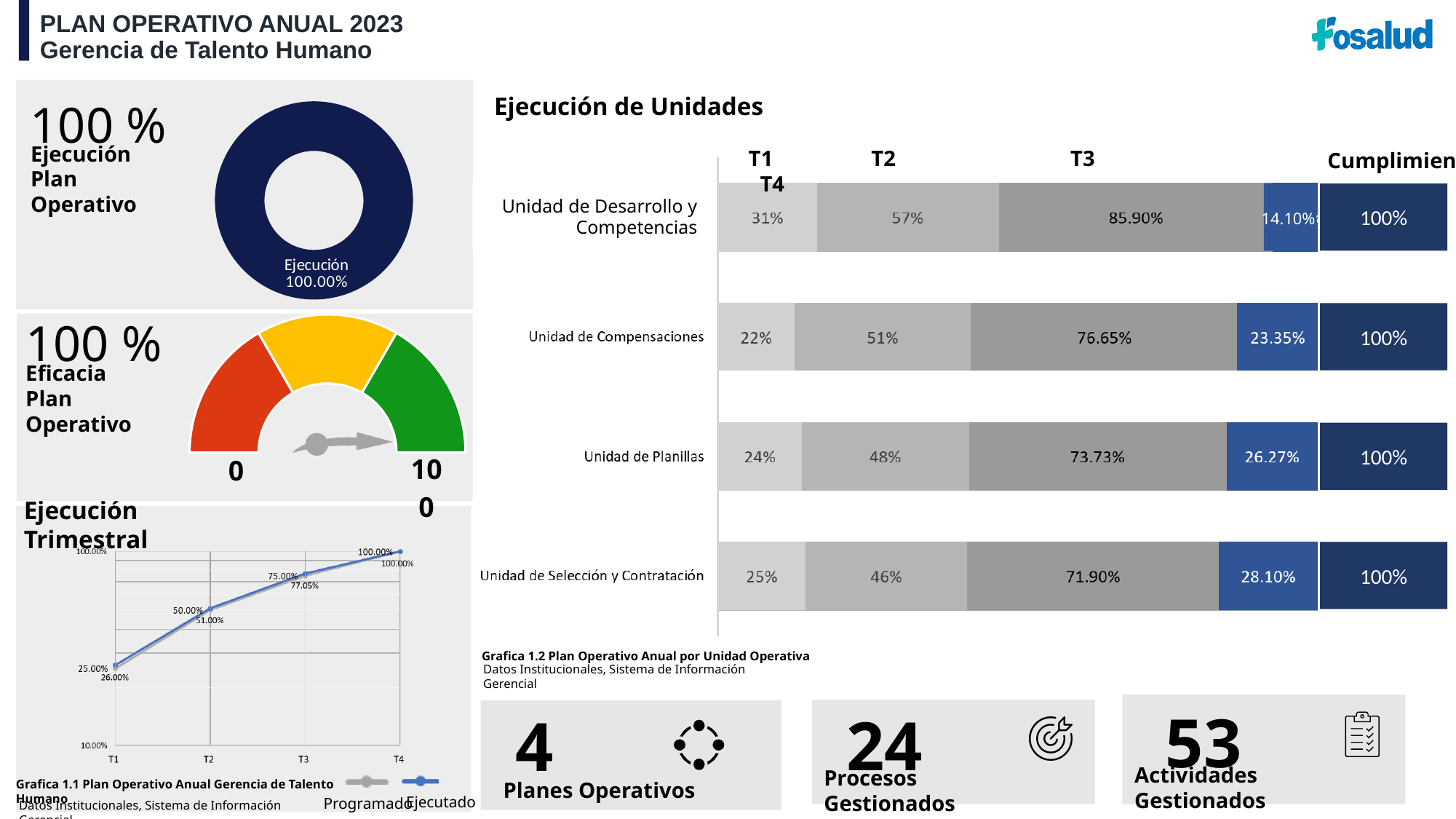
In the 'Ejecución de Unidades' chart, which has the larger T4 value: Unidad de Compensaciones or Unidad de Planillas? Unidad de Planillas What kind of chart is the 'Ejecución de Unidades' chart? Stacked bar chart In the 'Ejecución Trimestral' line chart, do the values rise or fall from T1 to T4? Rise How many series does the 'Ejecución de Unidades' chart show (T1, T2, T3, T4, Cumplimiento)? 5 In the 'Ejecución de Unidades' chart, what is the difference between the T2 value for Unidad de Desarrollo y Competencias and the T2 value for Unidad de Selección y Contratación? 11 percentage points In the 'Ejecución de Unidades' chart, what is the T3 value for Unidad de Compensaciones? 76.65% In the 'Ejecución de Unidades' chart, which unit has the lowest T3 value? Unidad de Selección y Contratación In the 'Ejecución Trimestral' line chart, what is the Ejecutado value at T3? 77.05% In the 'Ejecución Trimestral' line chart, what is the Programado value at T2? 50.00% In the 'Ejecución de Unidades' chart, what is the T4 value for Unidad de Planillas? 26.27% In the 'Ejecución de Unidades' chart, which unit has the highest T1 value? Unidad de Desarrollo y Competencias How many units are shown in the 'Ejecución de Unidades' chart? 4